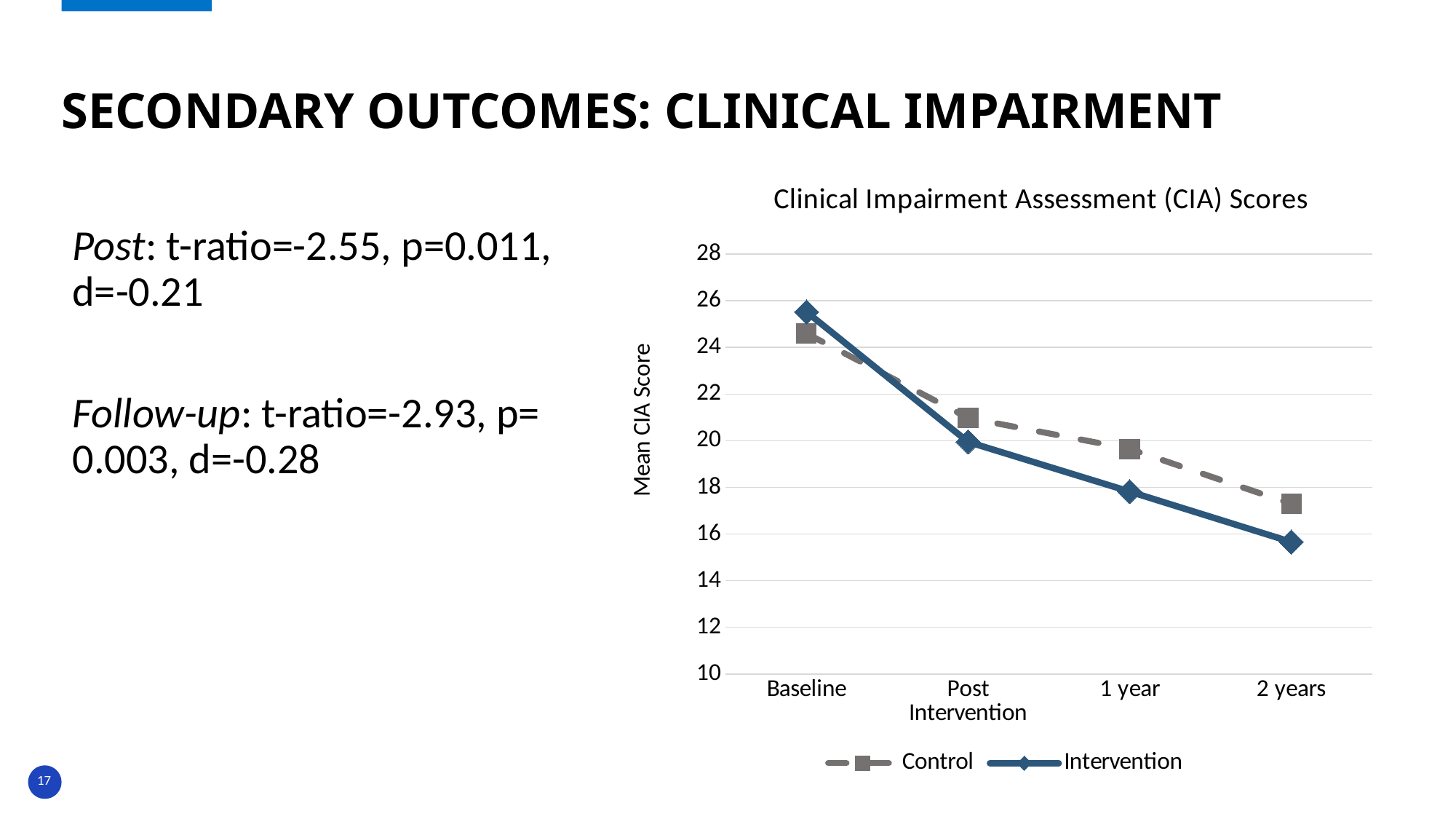
Is the Intervention value at 2 years greater or less than 16? less What is the title of the chart? Clinical Impairment Assessment (CIA) Scores At which time point is the Control series at its highest? Baseline How many time points are plotted along the x axis? 4 What kind of chart is shown on the slide? line chart At which time point is the Intervention series at its lowest? 2 years How many series does the chart's legend list? 2 Do the Intervention scores rise or fall from Baseline to 2 years? fall At 2 years, which series has the higher Mean CIA Score, Control or Intervention? Control Is the Control value at Post Intervention greater or less than 20? greater What is the label on the vertical axis of the chart? Mean CIA Score At Baseline, which series has the higher Mean CIA Score, Control or Intervention? Intervention